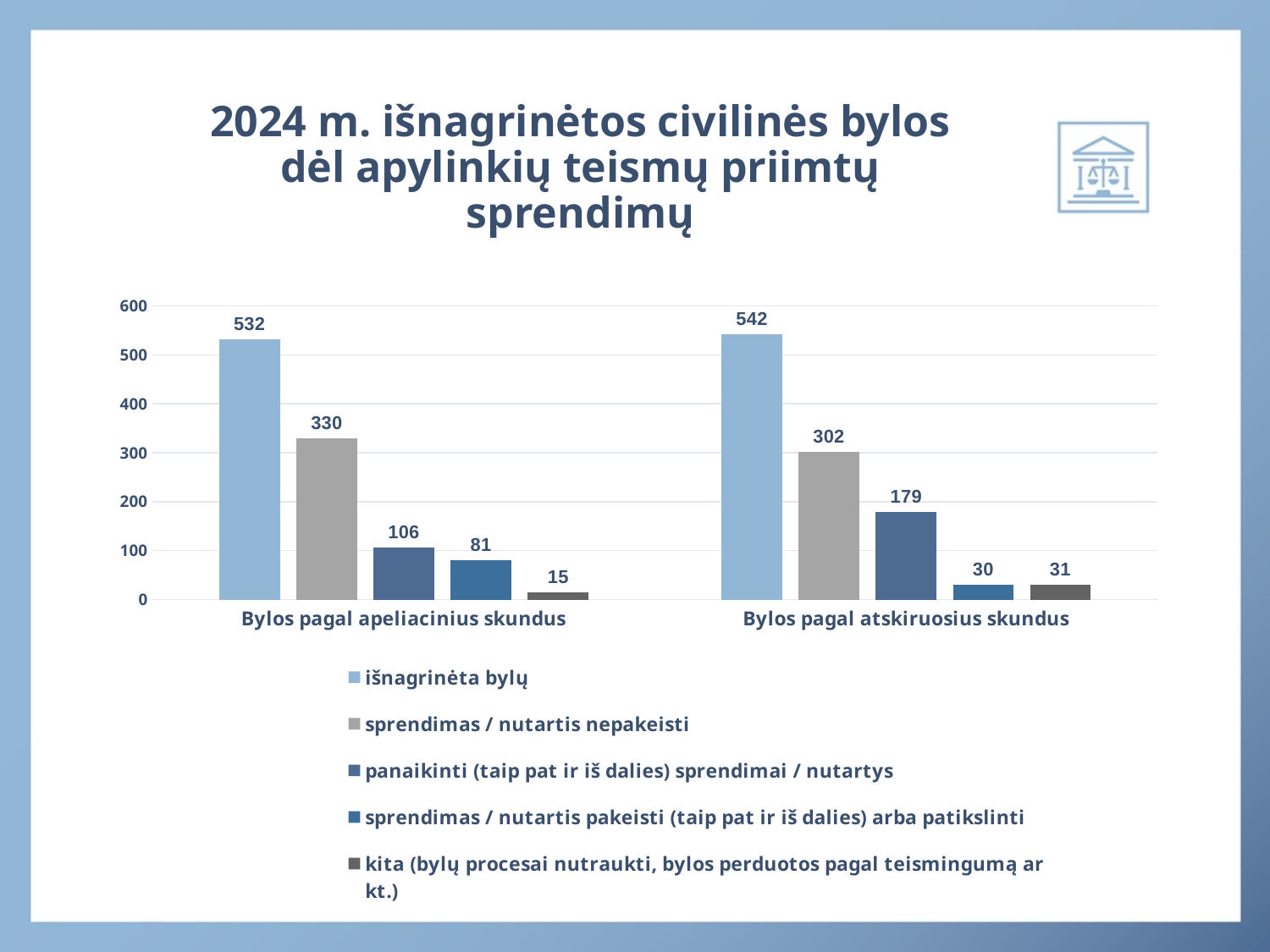
What is the difference between "išnagrinėta bylų" for "Bylos pagal atskiruosius skundus" and for "Bylos pagal apeliacinius skundus"? 10 What is the value of "išnagrinėta bylų" for "Bylos pagal apeliacinius skundus"? 532 Which series has the highest value for "Bylos pagal atskiruosius skundus"? išnagrinėta bylų What is the value of "sprendimas / nutartis nepakeisti" for "Bylos pagal atskiruosius skundus"? 302 How many categories are shown on the x axis? 2 What kind of chart is shown on the slide? bar chart Which is larger: "sprendimas / nutartis pakeisti (taip pat ir iš dalies) arba patikslinti" for "Bylos pagal apeliacinius skundus" or for "Bylos pagal atskiruosius skundus"? Bylos pagal apeliacinius skundus What is the value of "panaikinti (taip pat ir iš dalies) sprendimai / nutartys" for "Bylos pagal atskiruosius skundus"? 179 What is the value of "kita (bylų procesai nutraukti, bylos perduotos pagal teismingumą ar kt.)" for "Bylos pagal apeliacinius skundus"? 15 What is the difference between "sprendimas / nutartis nepakeisti" for "Bylos pagal apeliacinius skundus" and for "Bylos pagal atskiruosius skundus"? 28 How many series does the legend list? 5 Which series has the lowest value for "Bylos pagal apeliacinius skundus"? kita (bylų procesai nutraukti, bylos perduotos pagal teismingumą ar kt.)